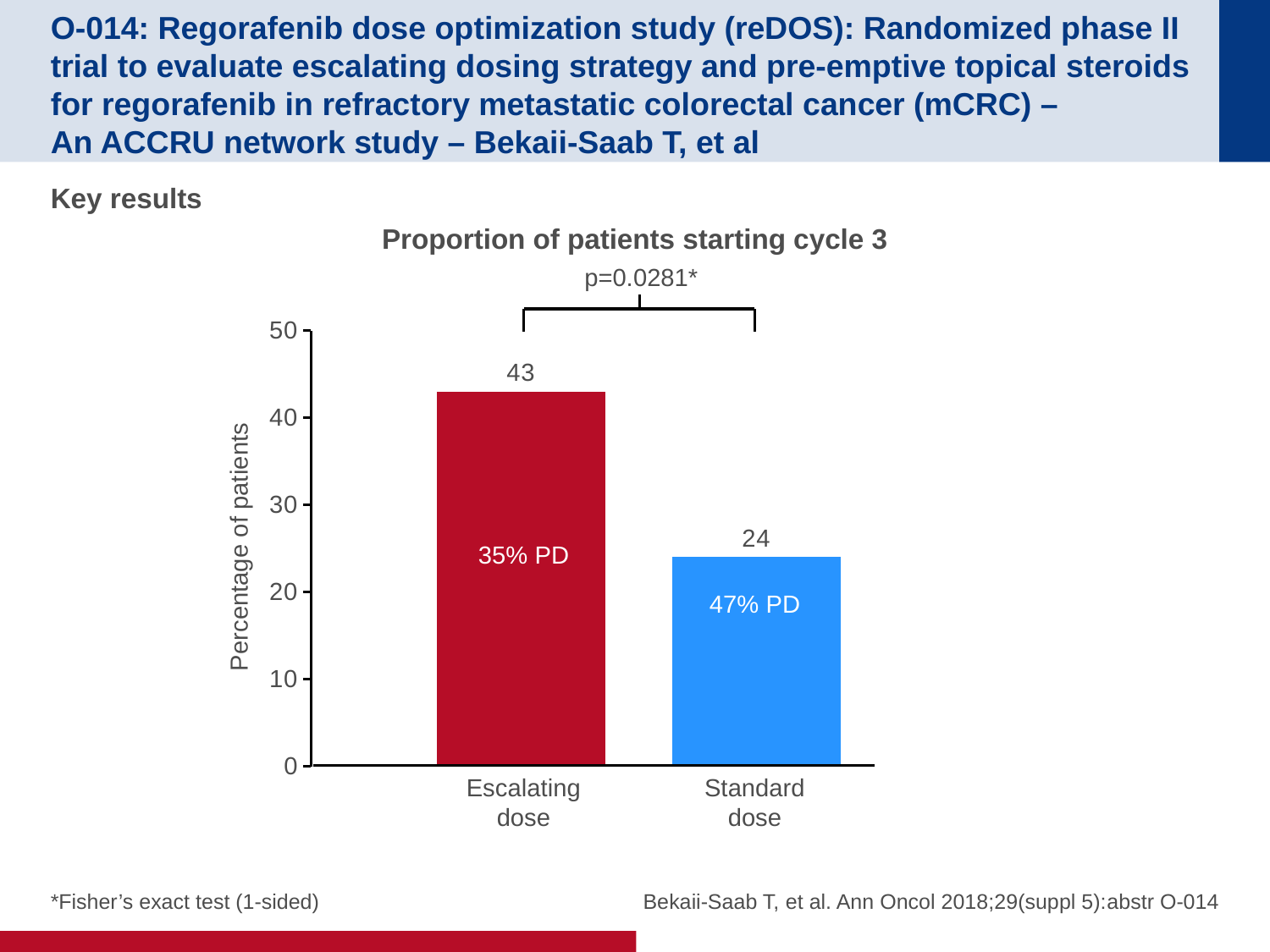
What is the value for Escalating dose? 43 What is the y-axis label of the chart? Percentage of patients What PD percentage is printed inside the Standard dose bar? 47% PD How many categories are shown on the x axis? 2 Which is larger, the value for Escalating dose or Standard dose? Escalating dose What kind of chart is shown? bar chart Which category has the lowest value? Standard dose What is the title of the chart? Proportion of patients starting cycle 3 What is the value for Standard dose? 24 Which category has the highest value? Escalating dose Is the value for Standard dose greater or less than 30? less What is the difference between the values for Escalating dose and Standard dose? 19